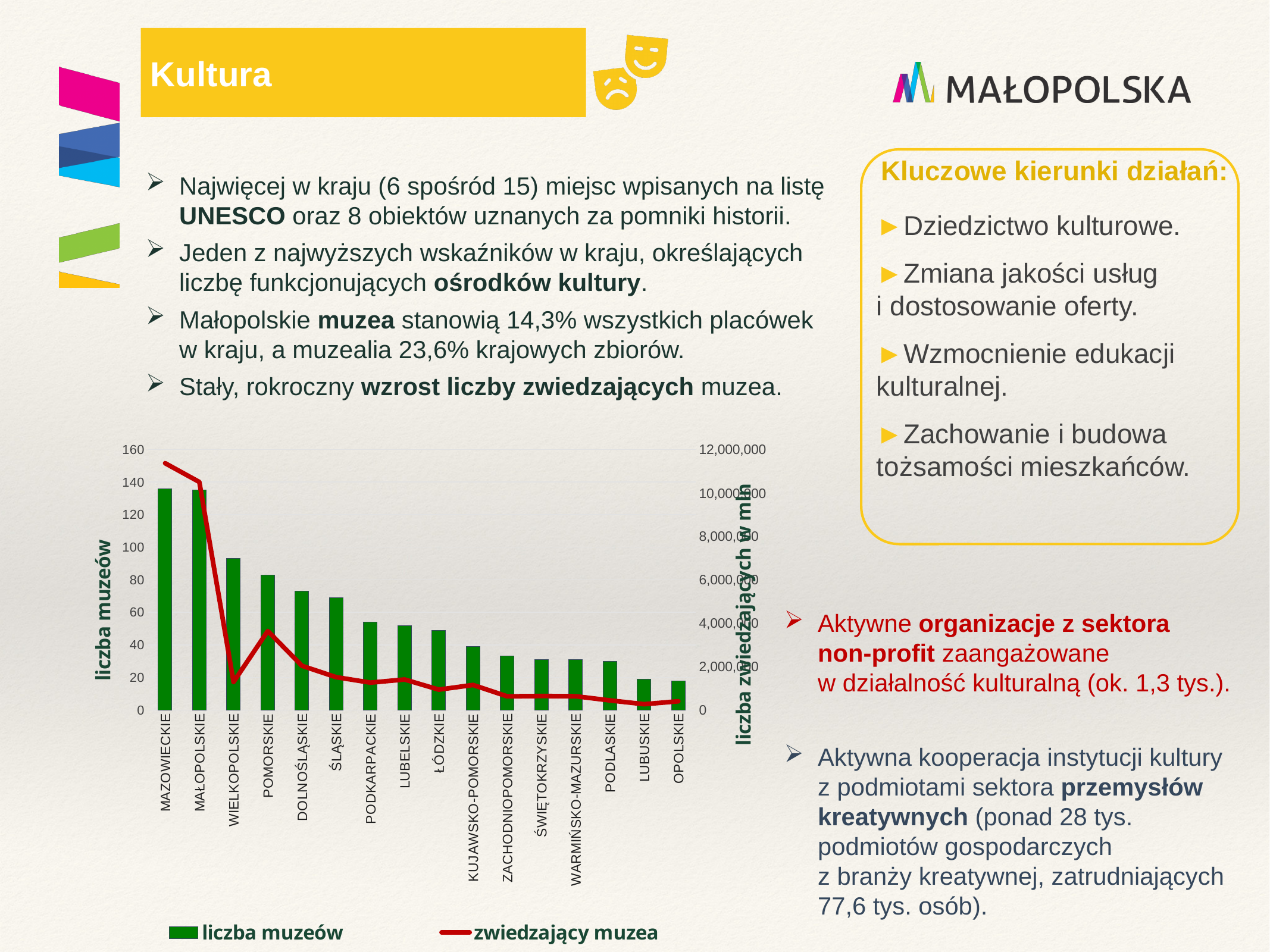
How many series does the chart legend list? 2 Which series is drawn as a red line in the chart? zwiedzający muzea Is the 'zwiedzający muzea' value for WIELKOPOLSKIE greater or less than 2,000,000? less Do the 'liczba muzeów' bars generally rise or fall from left to right along the x axis? fall Which has more museums ('liczba muzeów'): WIELKOPOLSKIE or POMORSKIE? WIELKOPOLSKIE Is the 'zwiedzający muzea' value for MAŁOPOLSKIE greater or less than 8,000,000? greater What kind of chart is shown on the slide? A combined bar and line chart How many voivodeships (categories) are shown on the x axis of the chart? 16 Which voivodeship has the highest value for the 'zwiedzający muzea' line? MAZOWIECKIE Is the 'liczba muzeów' value for WIELKOPOLSKIE greater or less than 80? greater What is the title of the left vertical axis of the chart? liczba muzeów